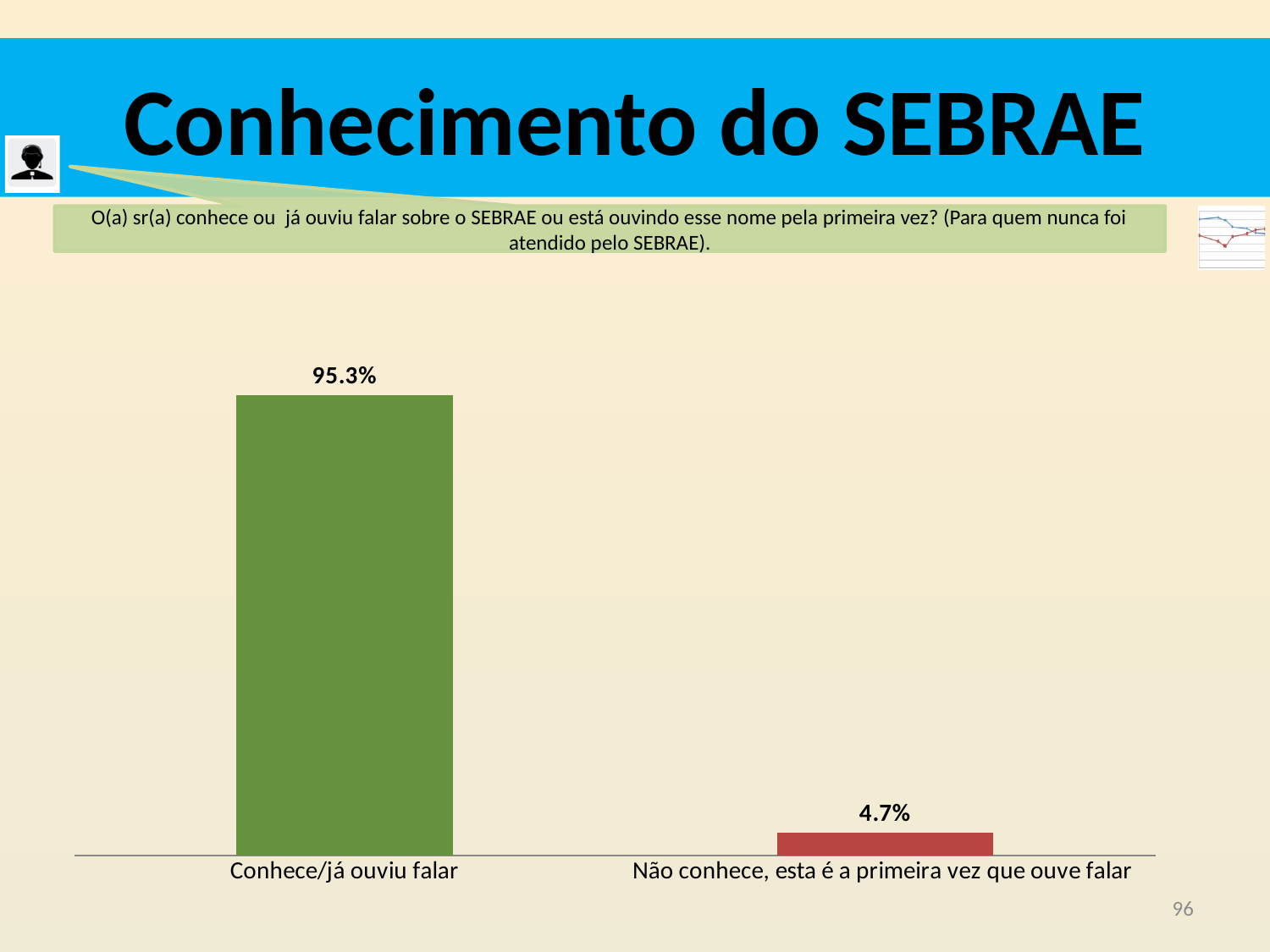
What is the difference between the values for "Conhece/já ouviu falar" and "Não conhece, esta é a primeira vez que ouve falar"? 90.6% How many categories are shown in the chart? 2 Which category has the lowest value? Não conhece, esta é a primeira vez que ouve falar What colour is the bar for "Conhece/já ouviu falar"? Green What is the value for "Conhece/já ouviu falar"? 95.3% What is the value for "Não conhece, esta é a primeira vez que ouve falar"? 4.7% Which category has the highest value? Conhece/já ouviu falar What is the title of the slide? Conhecimento do SEBRAE Which is larger: the value for "Conhece/já ouviu falar" or the value for "Não conhece, esta é a primeira vez que ouve falar"? Conhece/já ouviu falar What kind of chart is shown on the slide? Bar chart What is the total of the two values shown in the chart? 100%